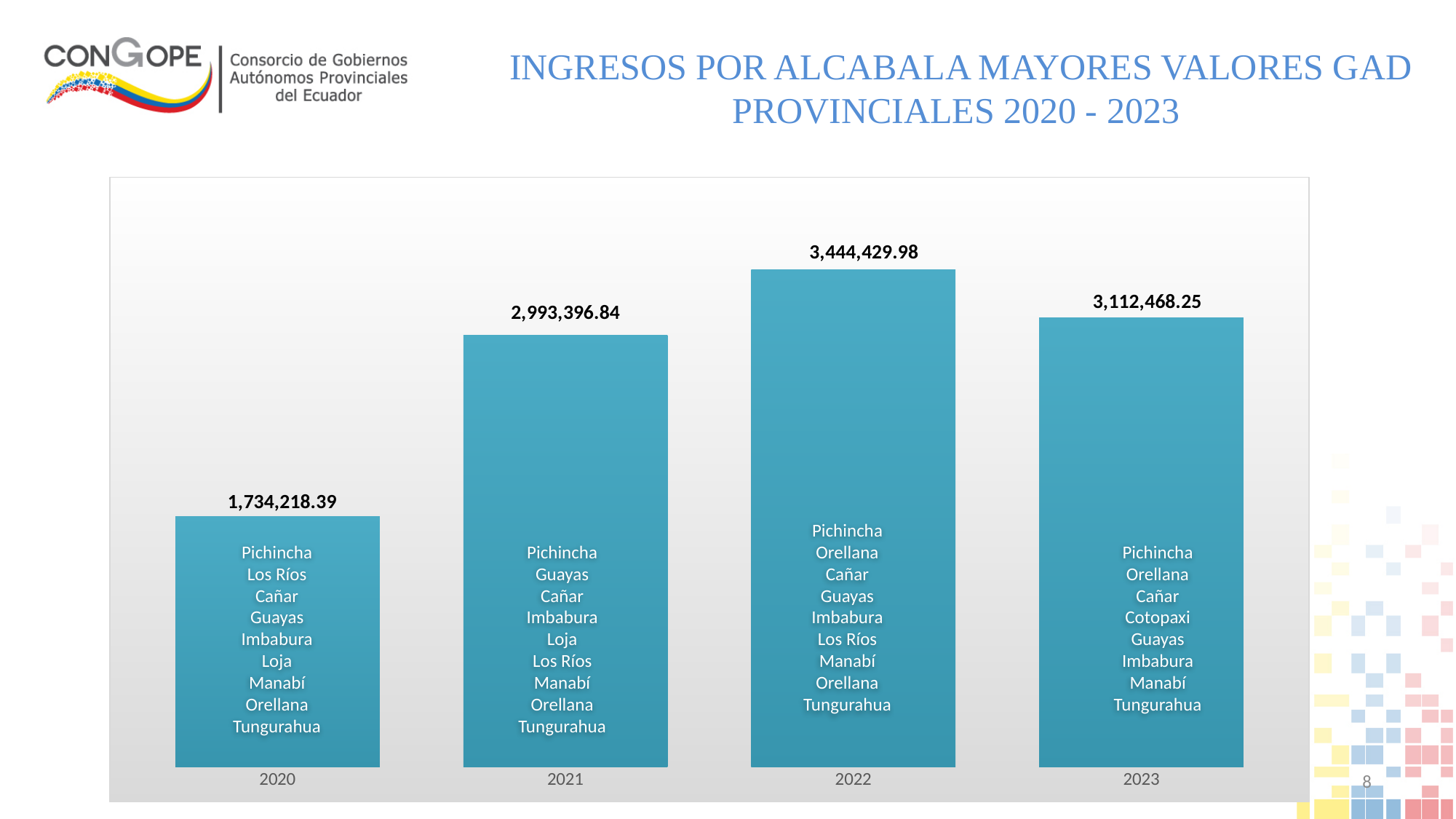
Does the value rise or fall from 2022 to 2023? Fall What kind of chart is shown on the slide? Bar chart What is the value shown for 2023? 3,112,468.25 What is the difference between the values for 2023 and 2020? 1,378,249.86 What is the difference between the values for 2022 and 2021? 451,033.14 Which year has the lowest value? 2020 How many years (bars) are shown in the chart? 4 Which province appears in the list inside the 2023 bar but not in the 2022 bar? Cotopaxi What is the value shown for 2022? 3,444,429.98 Which is larger, the value for 2021 or the value for 2023? 2023 What is the value shown for 2020? 1,734,218.39 Which year has the highest value? 2022